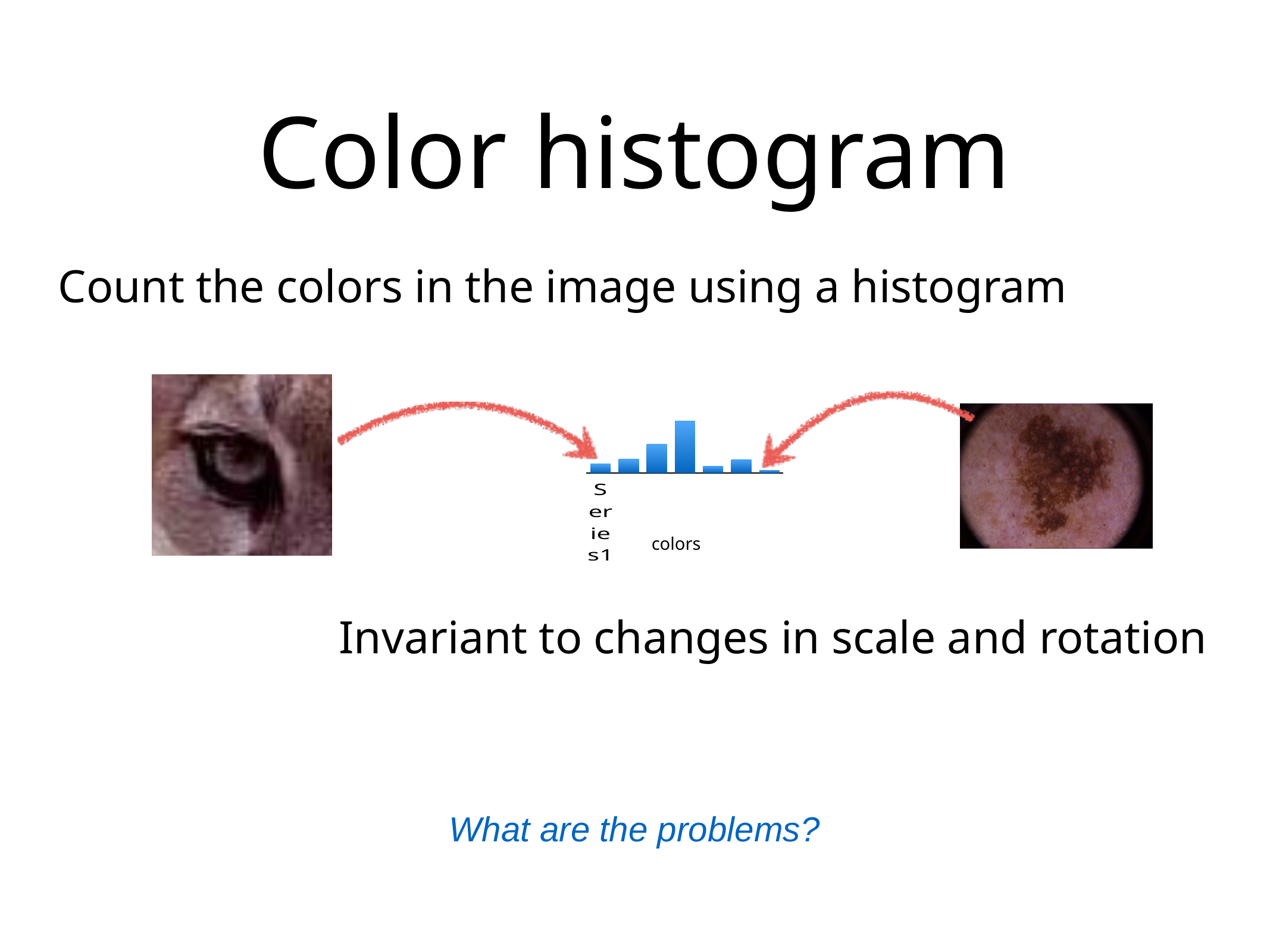
How many bars does the chart contain? 7 Which is taller, the second bar or the third bar from the left? the third bar Do the bar heights rise or fall from the fourth bar to the fifth bar? fall Which bar in the chart is the tallest, counting from the left? the fourth bar Which bar in the chart is the shortest, counting from the left? the seventh bar What label is printed below the chart's horizontal axis? colors What series name is printed under the chart? Series1 Which is taller, the fifth bar or the sixth bar from the left? the sixth bar What kind of chart is shown in the middle of the slide? bar chart Do the bar heights rise or fall from the first bar to the fourth bar? rise